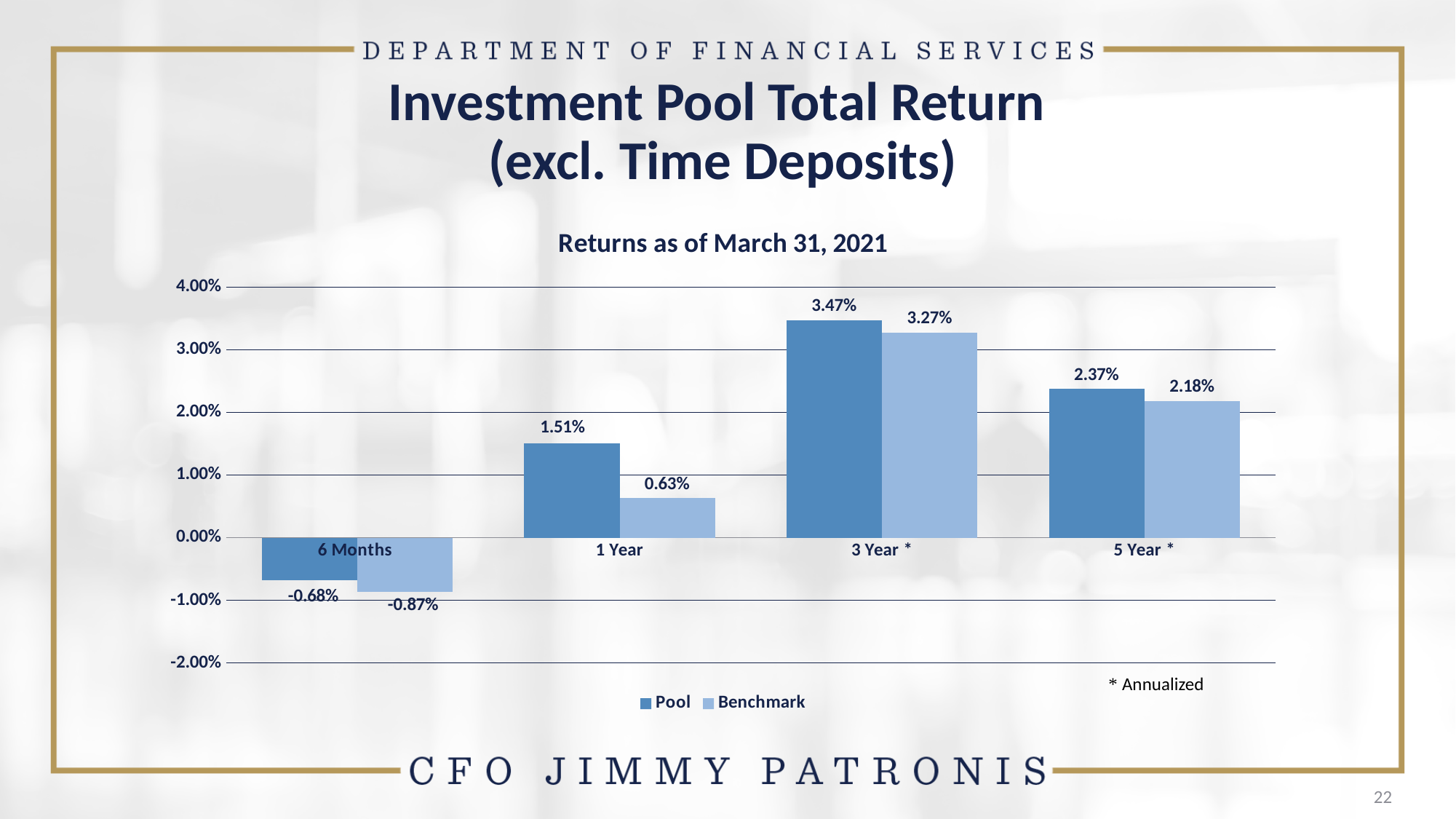
How many periods are shown on the x axis? 4 What is the Pool return for 1 Year? 1.51% What is the chart's title? Returns as of March 31, 2021 Which is larger for 5 Year, the Pool return or the Benchmark return? Pool Which period has the lowest Benchmark return? 6 Months What is the Benchmark return for 6 Months? -0.87% What is the difference between the Pool and Benchmark returns for 1 Year? 0.88% Which period has the highest Pool return? 3 Year What is the Pool return for 3 Year? 3.47% What kind of chart is shown? Bar chart What is the Benchmark return for 5 Year? 2.18% How many series does the legend list? 2